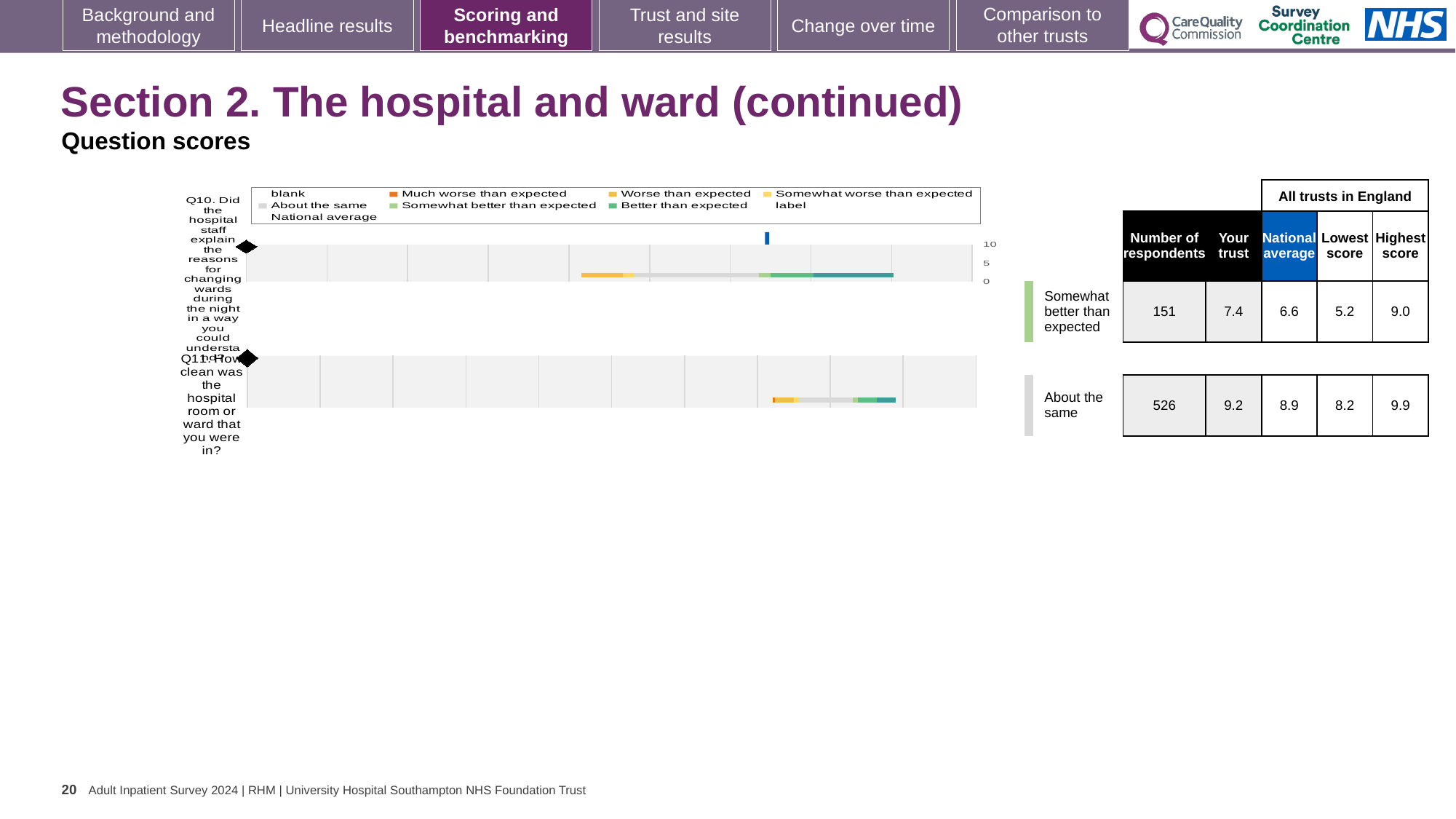
Which benchmark category is the trust's Q11 score placed in? About the same By how much does the trust's score for Q10 exceed the national average for Q10? 0.8 What kind of chart is used to show the question scores for Q10 and Q11? bar chart What is the national average score for Q11 (how clean was the hospital room or ward)? 8.9 How many respondents answered Q11? 526 What is the 'Your trust' score for Q10 (explaining reasons for changing wards during the night)? 7.4 How many questions are plotted in the chart area on this slide? 2 What is the lowest score across all trusts in England for Q11? 8.2 Which question has the higher 'Your trust' score, Q10 or Q11? Q11 What is the difference between the highest and lowest scores for Q11? 1.7 What is the highest score across all trusts in England for Q10? 9.0 Is the trust's score for Q10 greater or less than 5 on the chart axis? greater